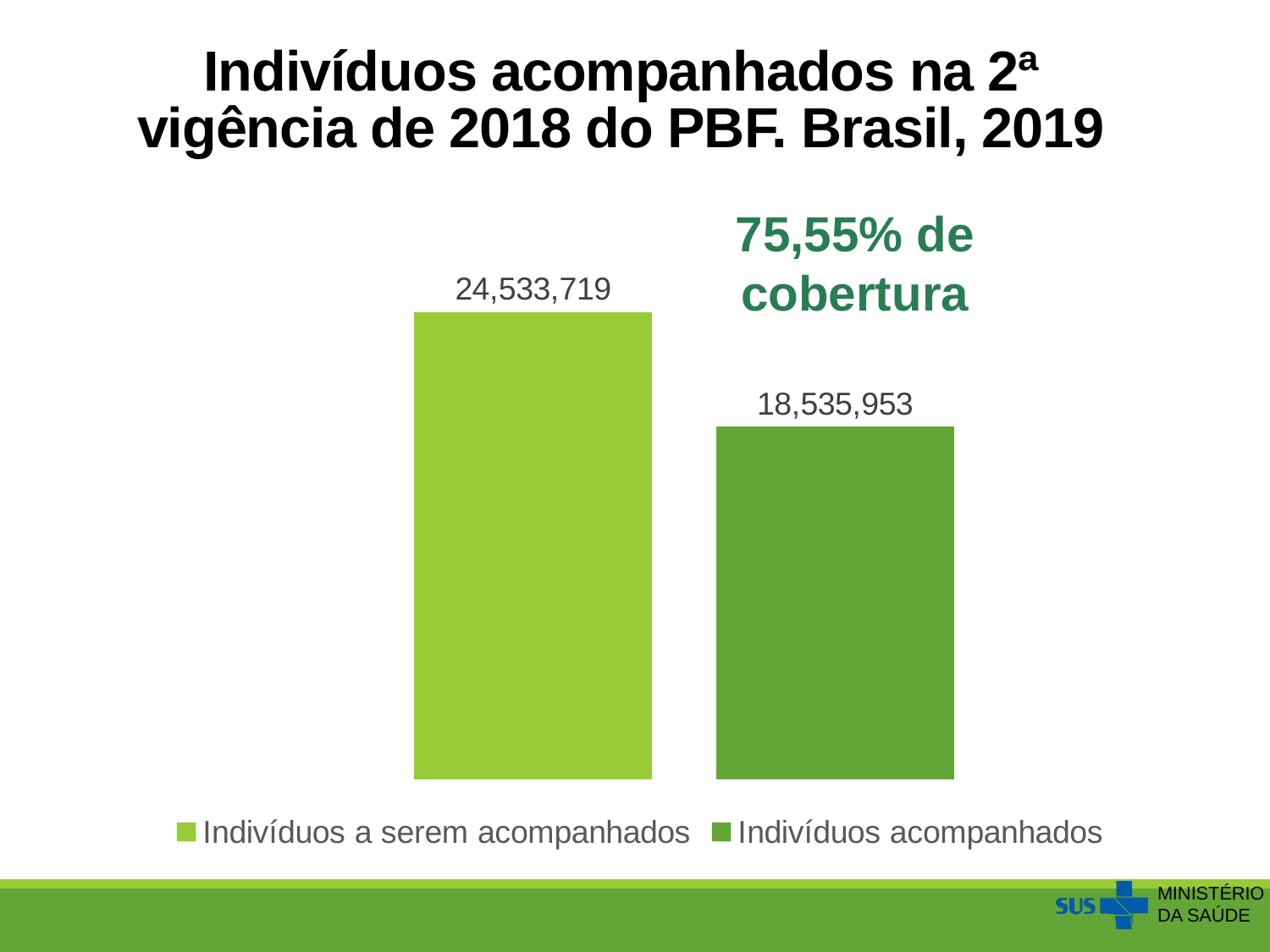
What is the title of the chart? Indivíduos acompanhados na 2ª vigência de 2018 do PBF. Brasil, 2019 What is the difference between 'Indivíduos a serem acompanhados' and 'Indivíduos acompanhados'? 5,997,766 What kind of chart is shown on the slide? bar chart What is the value for 'Indivíduos a serem acompanhados'? 24,533,719 Which series has the higher value? Indivíduos a serem acompanhados How many series does the legend list? 2 What is the value for 'Indivíduos acompanhados'? 18,535,953 How many bars are plotted in the chart? 2 What coverage percentage is stated on the slide? 75,55% Which series has the lower value? Indivíduos acompanhados Is the value for 'Indivíduos acompanhados' larger or smaller than the value for 'Indivíduos a serem acompanhados'? smaller